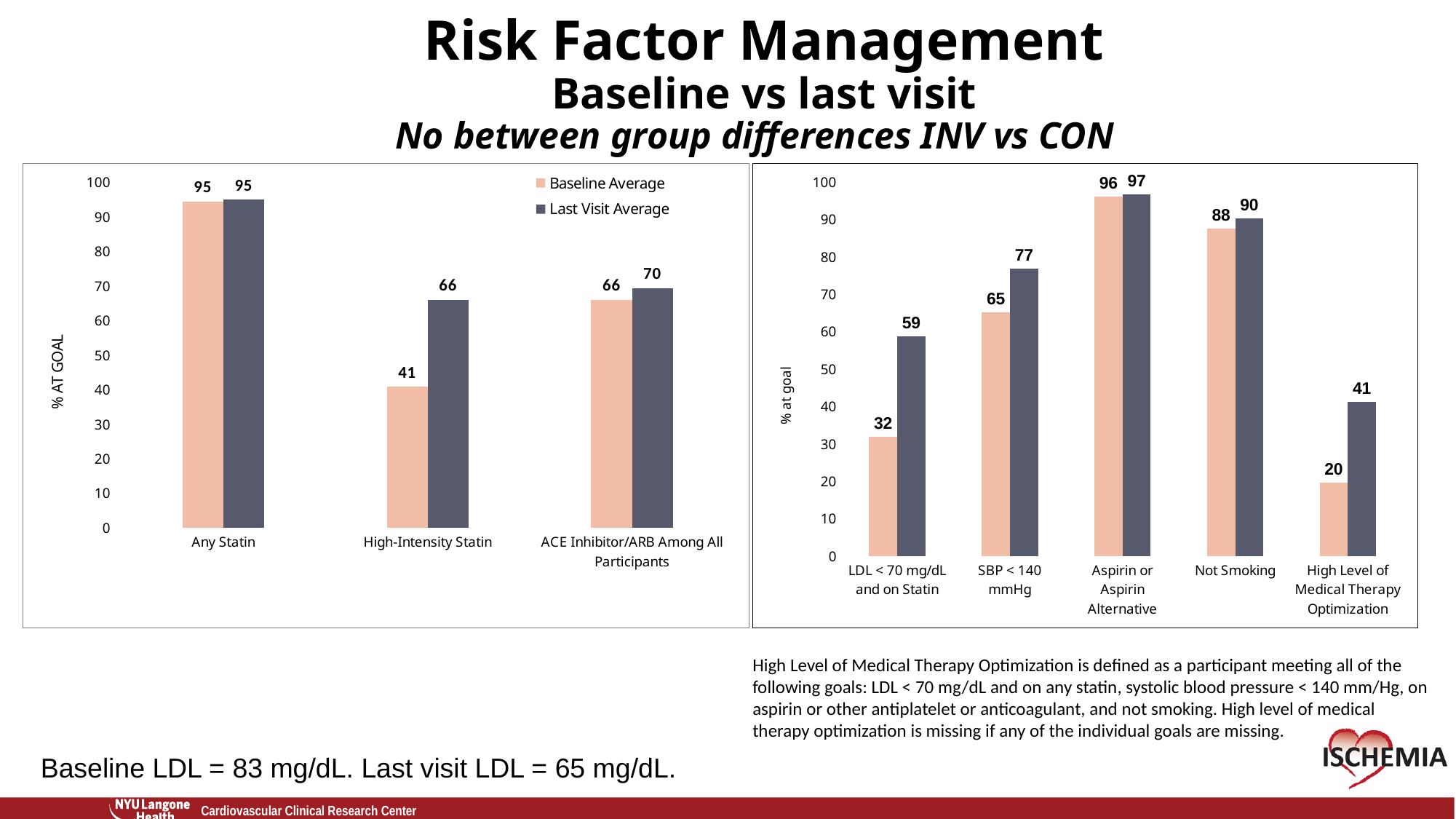
In the left chart, what is the Last Visit Average value for ACE Inhibitor/ARB Among All Participants? 70 What type of chart is the left chart? Bar chart How many series does the legend on the left chart list? 2 In the right chart, which category has the lowest Baseline Average value? High Level of Medical Therapy Optimization In the right chart, what is the Baseline Average value for LDL < 70 mg/dL and on Statin? 32 In the right chart, what is the Last Visit Average value for SBP < 140 mmHg? 77 In the left chart, what is the Baseline Average value for High-Intensity Statin? 41 In the right chart, what is the difference between the Last Visit Average and Baseline Average for LDL < 70 mg/dL and on Statin? 27 In the left chart, what is the difference between the Last Visit Average and Baseline Average for High-Intensity Statin? 25 In the right chart, which is larger: the Baseline Average for Not Smoking or the Baseline Average for SBP < 140 mmHg? Not Smoking How many categories are shown on the x axis of the right chart? 5 In the right chart, which category has the highest Last Visit Average value? Aspirin or Aspirin Alternative